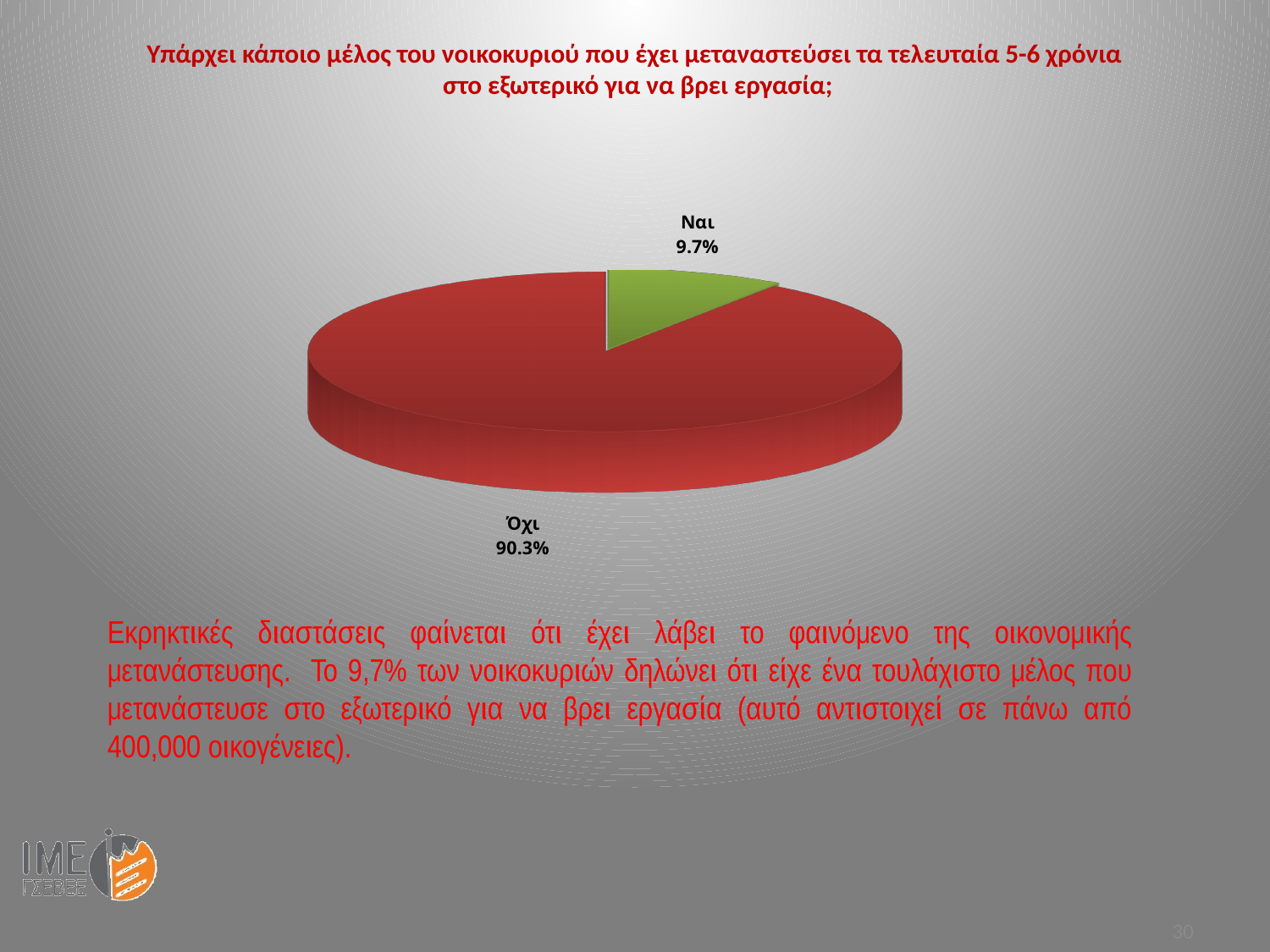
What percentage of the pie is labelled "Όχι"? 90.3% What kind of chart is shown on the slide? Pie chart Which slice of the pie is the largest? Όχι What is the difference in percentage points between the "Όχι" and "Ναι" slices? 80.6 What colour is the "Όχι" slice of the pie? Red What colour is the "Ναι" slice of the pie? Green What percentage of the pie is labelled "Ναι"? 9.7% Which slice of the pie is the smallest? Ναι What share of the pie does the "Ναι" slice represent? 9.7% How many slices does the pie chart have? 2 Which is larger, the "Ναι" slice or the "Όχι" slice? Όχι